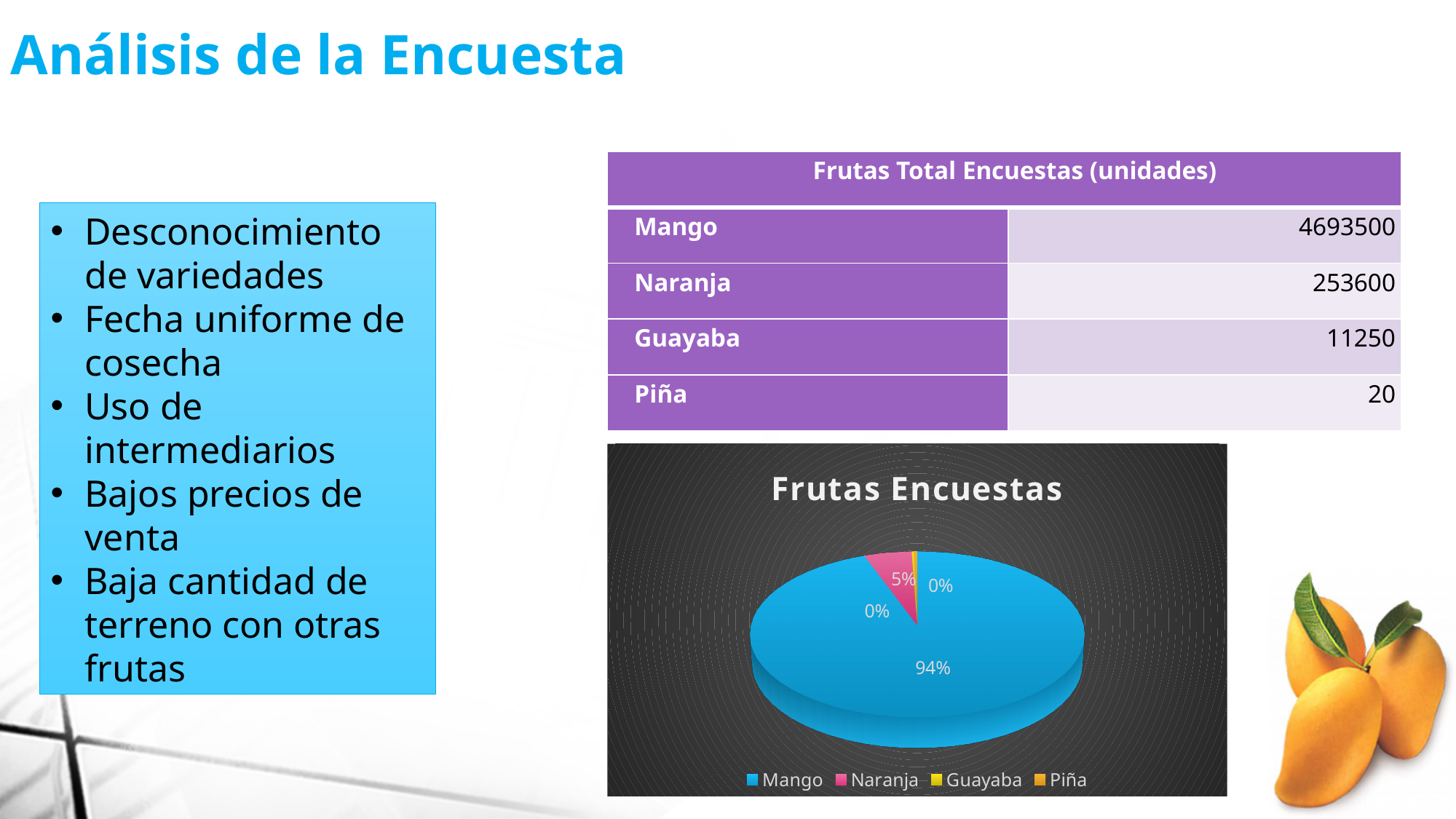
What is the title of the pie chart? Frutas Encuestas Which category has the largest slice in the pie chart? Mango What kind of chart is shown under the title "Frutas Encuestas"? pie chart Which colour represents Mango in the pie chart legend? blue What share of the pie chart does Naranja represent? 5% How many categories are shown in the pie chart? 4 How many entries does the legend of the pie chart list? 4 Which is larger in the pie chart, the Mango slice or the Naranja slice? Mango What percentage label is shown for Guayaba in the pie chart? 0% What is the difference in percentage points between the Mango slice and the Naranja slice in the pie chart? 89% What share of the pie chart does Mango represent? 94% Is the Mango share in the pie chart greater or less than 50%? greater